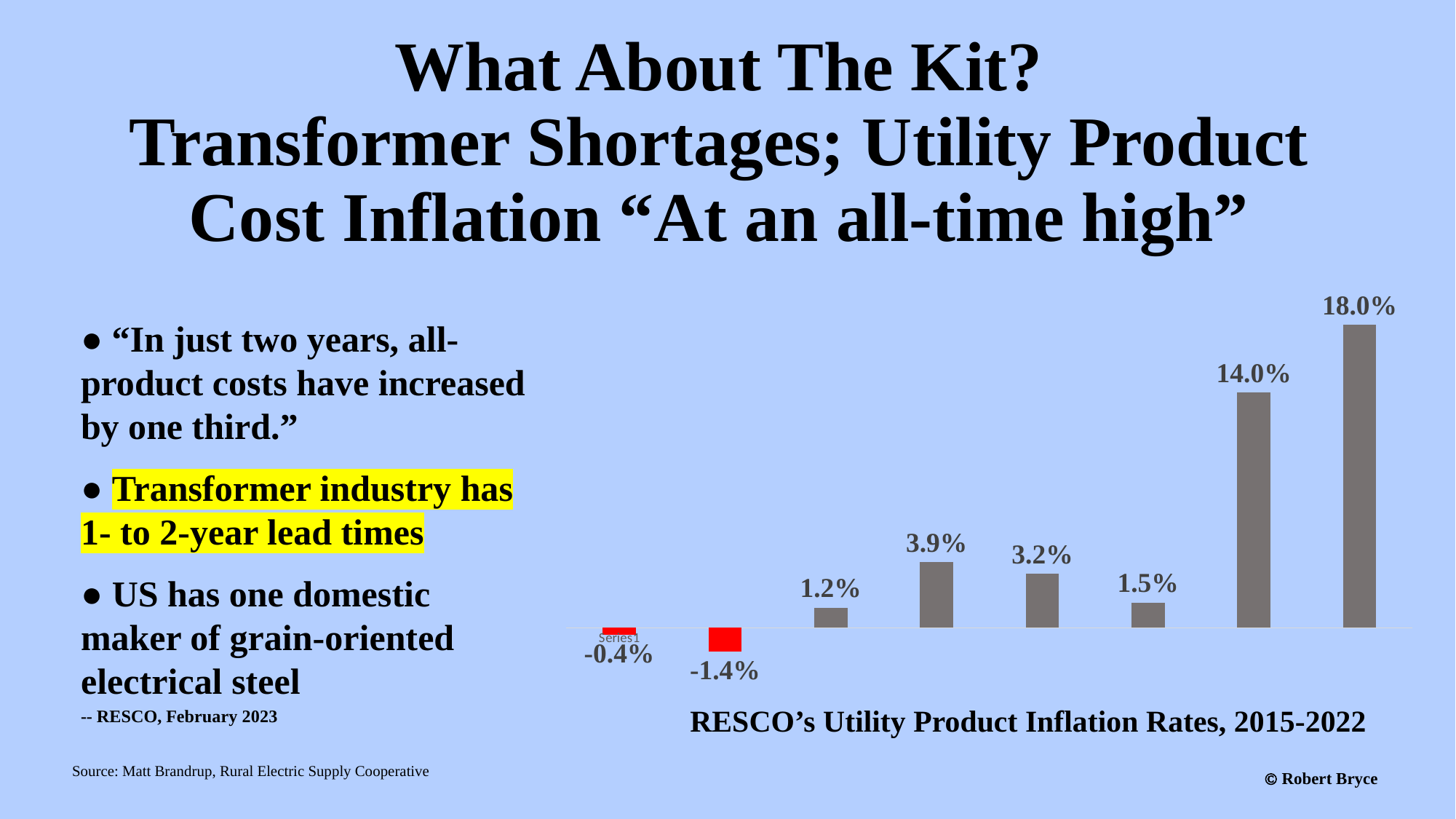
What is the difference between the two tallest bars (18.0% and 14.0%)? 4.0% What is the value of the second-tallest bar in the chart? 14.0% What is the value of the third bar from the left? 1.2% What is the difference between the 3.9% bar and the 3.2% bar? 0.7% What kind of chart is shown on the slide? bar chart Do the values of the last three bars rise or fall from left to right? rise What is the lowest value shown in the chart? -1.4% What is the highest value shown in the chart? 18.0% How many bars are plotted in the chart? 8 Which is larger, the fourth bar from the left (3.9%) or the fifth bar from the left (3.2%)? the fourth bar (3.9%) What is the title of the chart? RESCO's Utility Product Inflation Rates, 2015-2022 How many bars in the chart have negative values? 2